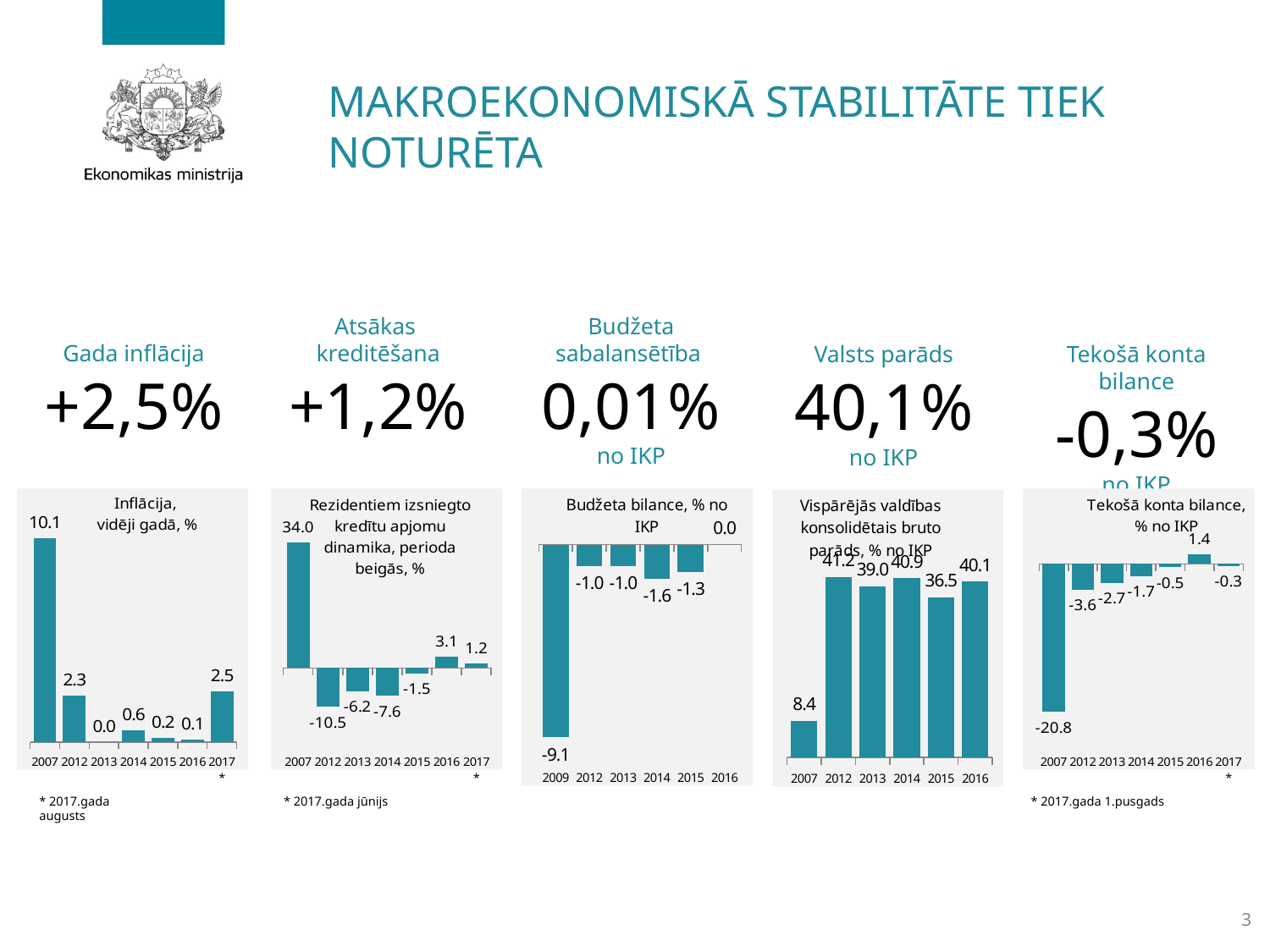
What type of chart is the 'Vispārējās valdības konsolidētais bruto parāds, % no IKP' chart? Bar chart In the 'Rezidentiem izsniegto kredītu apjomu dinamika, perioda beigās, %' chart, which year has the highest value? 2007 In the 'Vispārējās valdības konsolidētais bruto parāds, % no IKP' chart, what is the value for 2015? 36.5 In the 'Budžeta bilance, % no IKP' chart, what is the difference between the 2014 and 2015 values? 0.3 In the 'Budžeta bilance, % no IKP' chart, what is the value for 2009? -9.1 In the 'Inflācija, vidēji gadā, %' chart, which year has the lowest value? 2013 In the 'Tekošā konta bilance, % no IKP' chart, which year has the lowest value? 2007 In the 'Tekošā konta bilance, % no IKP' chart, what is the value for 2016? 1.4 In the 'Inflācija, vidēji gadā, %' chart, what is the value for 2007? 10.1 In the 'Rezidentiem izsniegto kredītu apjomu dinamika, perioda beigās, %' chart, what is the value for 2012? -10.5 In the 'Inflācija, vidēji gadā, %' chart, how many years are plotted? 7 In the 'Vispārējās valdības konsolidētais bruto parāds, % no IKP' chart, which is larger, the value for 2012 or the value for 2013? 2012